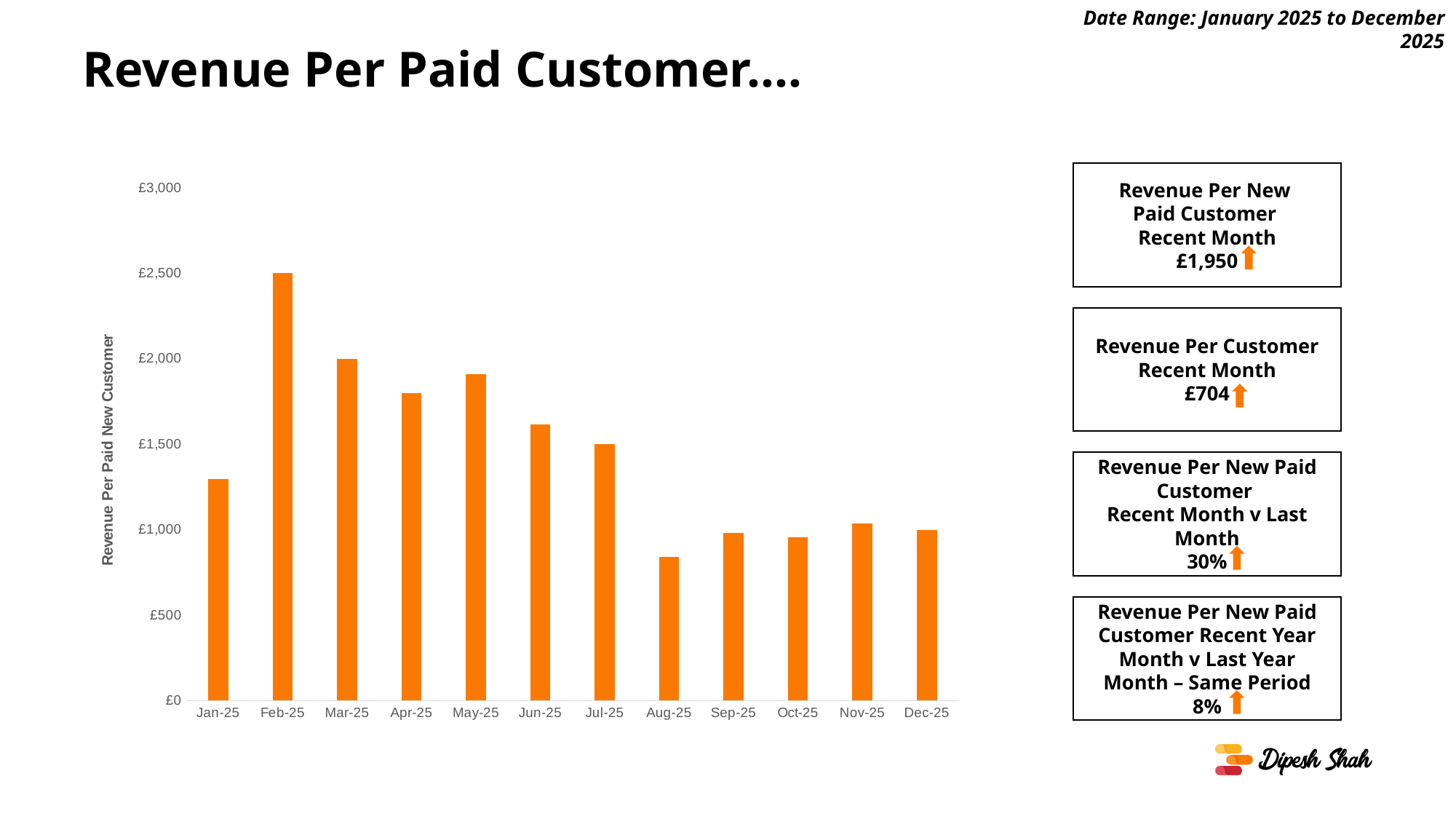
What kind of chart is shown on the slide? bar chart Which is larger, the value for Jan-25 or the value for Dec-25? Jan-25 Is the value for Aug-25 greater or less than £1,000? less How many months are plotted on the x axis of the chart? 12 Which is larger, the value for Mar-25 or the value for Apr-25? Mar-25 Is the value for Apr-25 greater or less than £2,000? less Is the value for May-25 greater or less than £1,500? greater What is the title of the y axis of the chart? Revenue Per Paid New Customer Which month has the lowest revenue per paid new customer? Aug-25 Do the values generally rise or fall from Feb-25 to Aug-25? fall Which month has the highest revenue per paid new customer? Feb-25